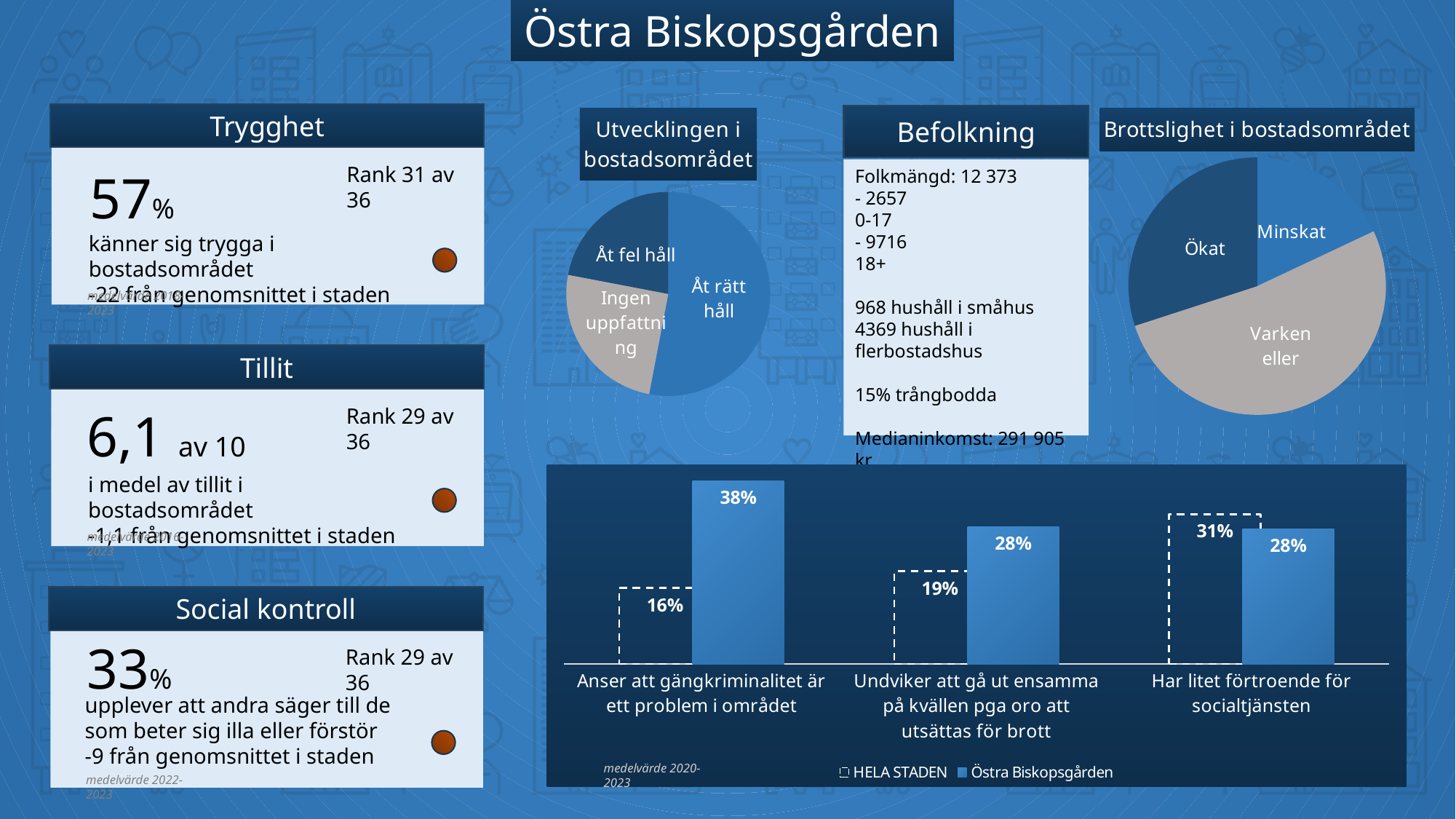
In the pie chart 'Brottslighet i bostadsområdet', which slice is the largest? Varken eller In the pie chart 'Utvecklingen i bostadsområdet', which slice is the largest? Åt rätt håll What kind of chart is 'Utvecklingen i bostadsområdet'? Pie chart How many series does the legend of the bar chart at the bottom list? 2 In the bar chart at the bottom, what is the value for HELA STADEN for 'Har litet förtroende för socialtjänsten'? 31% In the bar chart at the bottom, which category has the highest value for Östra Biskopsgården? Anser att gängkriminalitet är ett problem i området In the bar chart at the bottom, what is the value for Östra Biskopsgården for 'Anser att gängkriminalitet är ett problem i området'? 38% How many categories are shown in the bar chart at the bottom? 3 In the bar chart at the bottom, what is the difference between Östra Biskopsgården and HELA STADEN for 'Anser att gängkriminalitet är ett problem i området'? 22 percentage points In the bar chart at the bottom, which category has the lowest value for HELA STADEN? Anser att gängkriminalitet är ett problem i området In the bar chart at the bottom, what is the value for HELA STADEN for 'Undviker att gå ut ensamma på kvällen pga oro att utsättas för brott'? 19% In the bar chart at the bottom, for 'Har litet förtroende för socialtjänsten', which is larger: HELA STADEN or Östra Biskopsgården? HELA STADEN